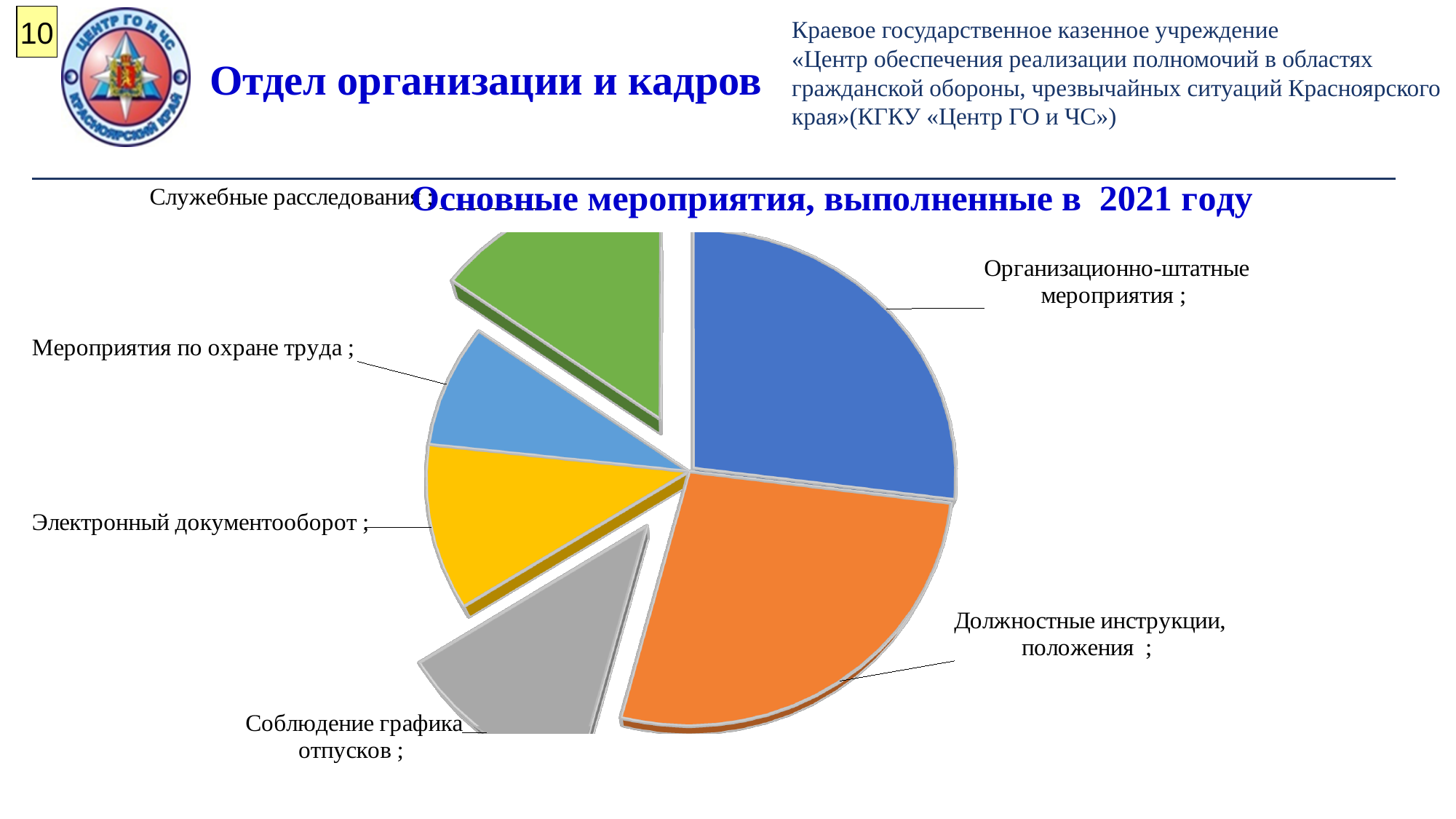
Which slice is larger: Должностные инструкции, положения or Электронный документооборот? Должностные инструкции, положения Which category is represented by the blue slice of the pie chart? Организационно-штатные мероприятия What is the title of the chart? Основные мероприятия, выполненные в 2021 году Which category has the smallest slice in the pie chart? Мероприятия по охране труда Which slice is larger: Организационно-штатные мероприятия or Мероприятия по охране труда? Организационно-штатные мероприятия What kind of chart is shown on the slide? pie chart How many slices does the pie chart have? 6 Which slice is larger: Организационно-штатные мероприятия or Служебные расследования? Организационно-штатные мероприятия